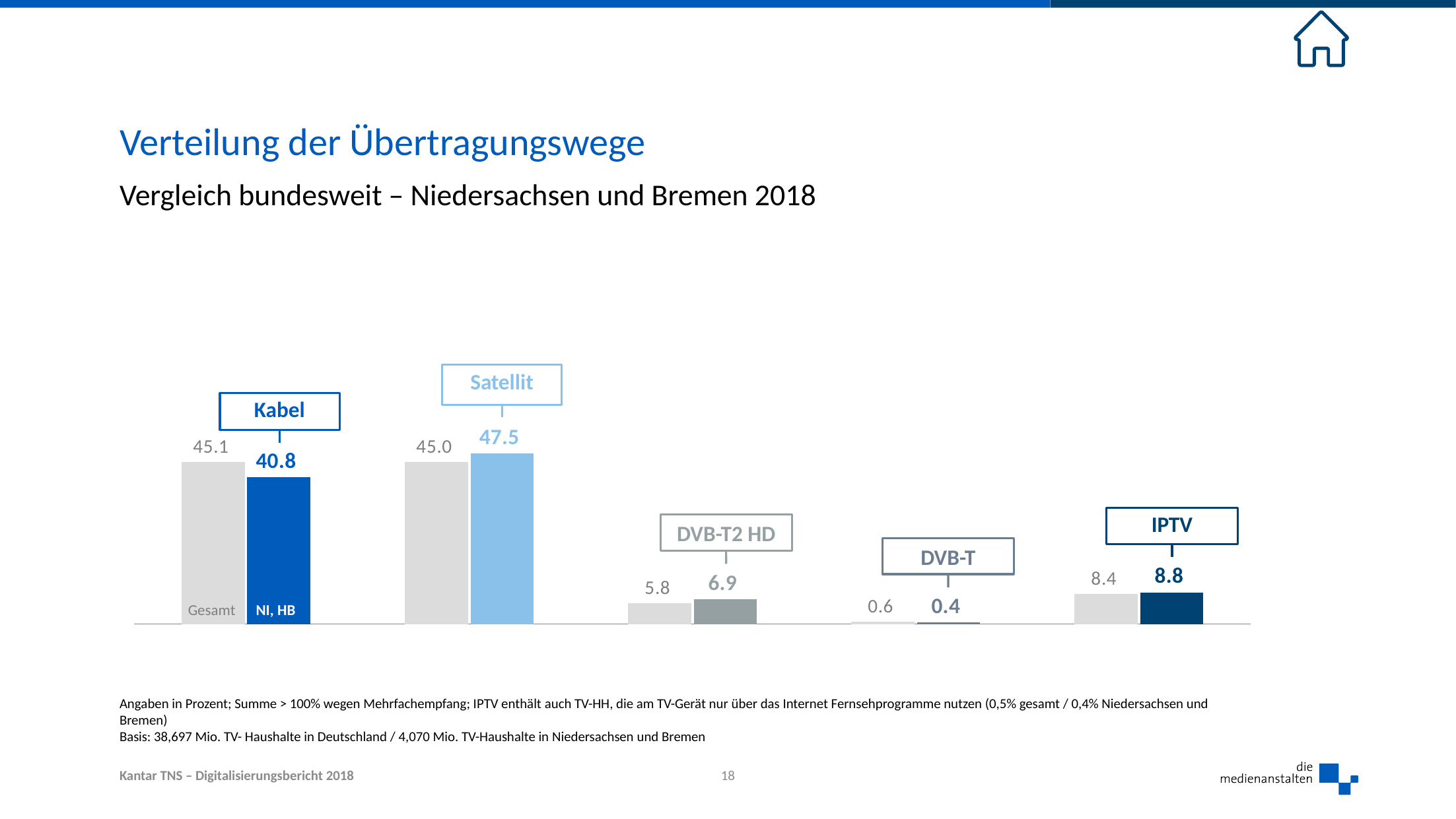
How many transmission categories are shown in the chart? 5 What is the Gesamt value for Kabel? 45.1 What is the Gesamt value for IPTV? 8.4 What type of chart is shown on the slide? Bar chart What is the difference between the NI, HB and Gesamt values for Satellit? 2.5 What is the NI, HB value for DVB-T2 HD? 6.9 What is the difference between the Gesamt and NI, HB values for Kabel? 4.3 Which category has the highest NI, HB value? Satellit How many series does the chart show per category? 2 What is the NI, HB value for Satellit? 47.5 Which is larger for DVB-T: the Gesamt value or the NI, HB value? Gesamt Which category has the lowest NI, HB value? DVB-T